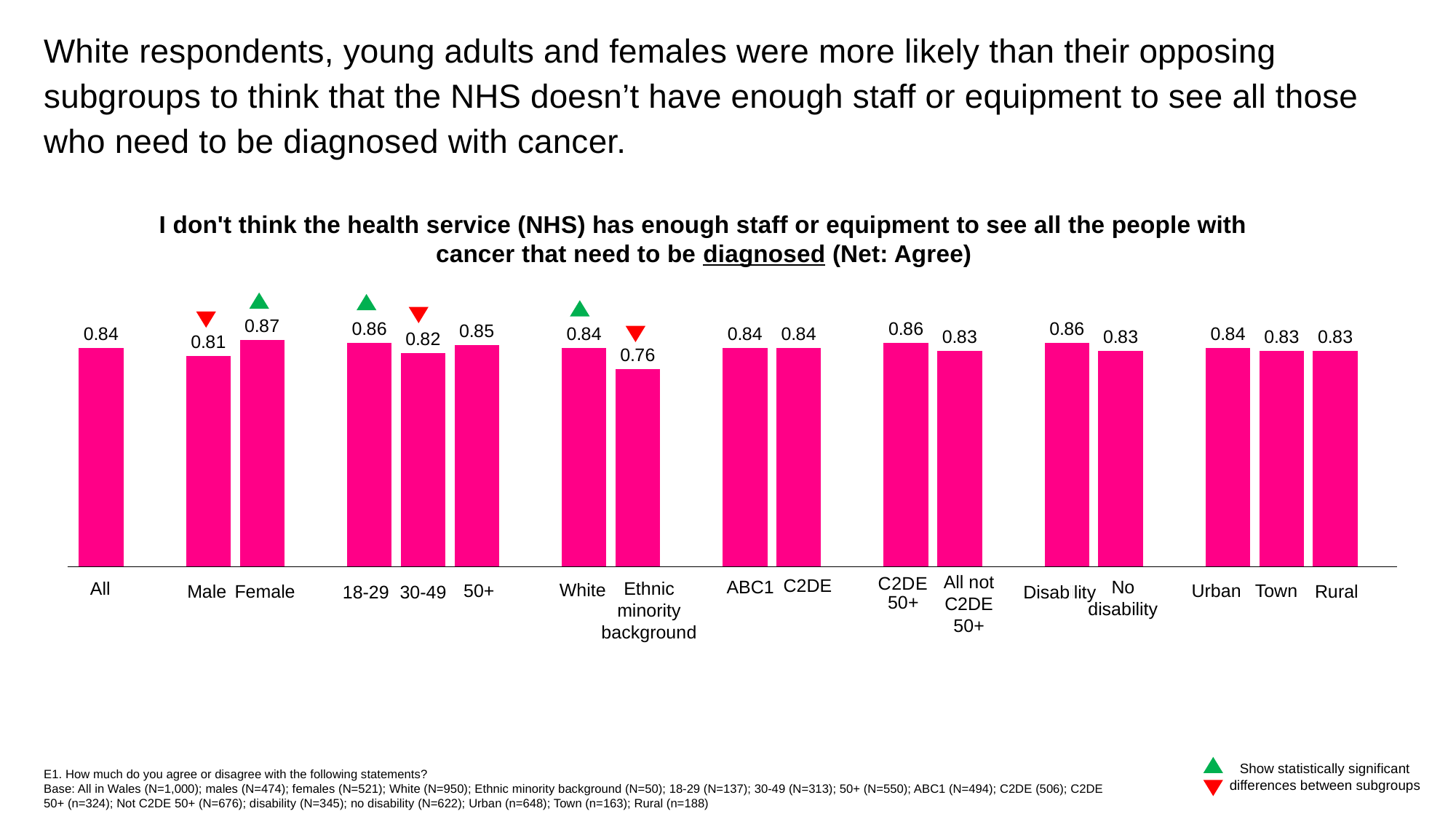
What is the value for Female? 0.87 How many bars are plotted in the chart? 17 Which category has the lowest value? Ethnic minority background What is the value for the All category? 0.84 What type of chart is shown? Bar chart What colour are the bars in the chart? Pink What is the difference between the values for White and Ethnic minority background? 0.08 What is the value for Ethnic minority background? 0.76 What is the value for 30-49? 0.82 Which category has the highest value? Female What is the difference between the values for Female and Male? 0.06 Which is larger, the value for 18-29 or the value for 30-49? 18-29